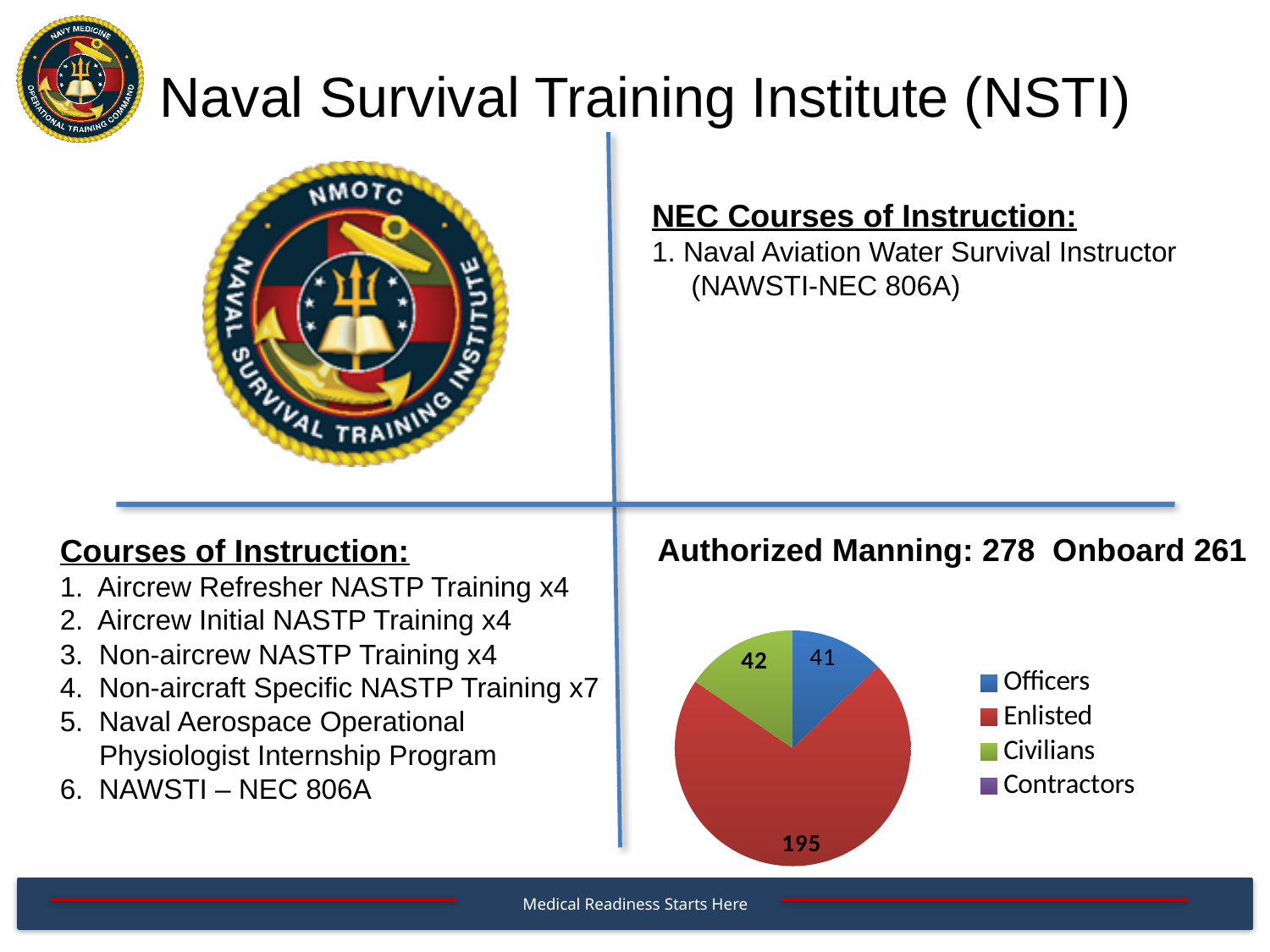
In the pie chart, what is the value for Civilians? 42 In the pie chart, what is the value for Enlisted? 195 What colour is the Enlisted slice in the pie chart? red What heading appears above the pie chart? Authorized Manning: 278 Onboard 261 What kind of chart is shown on the slide? pie chart How many entries does the pie chart's legend list? 4 In the pie chart, which is larger, Enlisted or Civilians? Enlisted Which category has the largest slice in the pie chart? Enlisted In the pie chart, what is the value for Officers? 41 What is the difference between the Civilians value and the Officers value in the pie chart? 1 What is the difference between the Enlisted value and the Officers value in the pie chart? 154 In the pie chart, which is larger, Civilians or Officers? Civilians